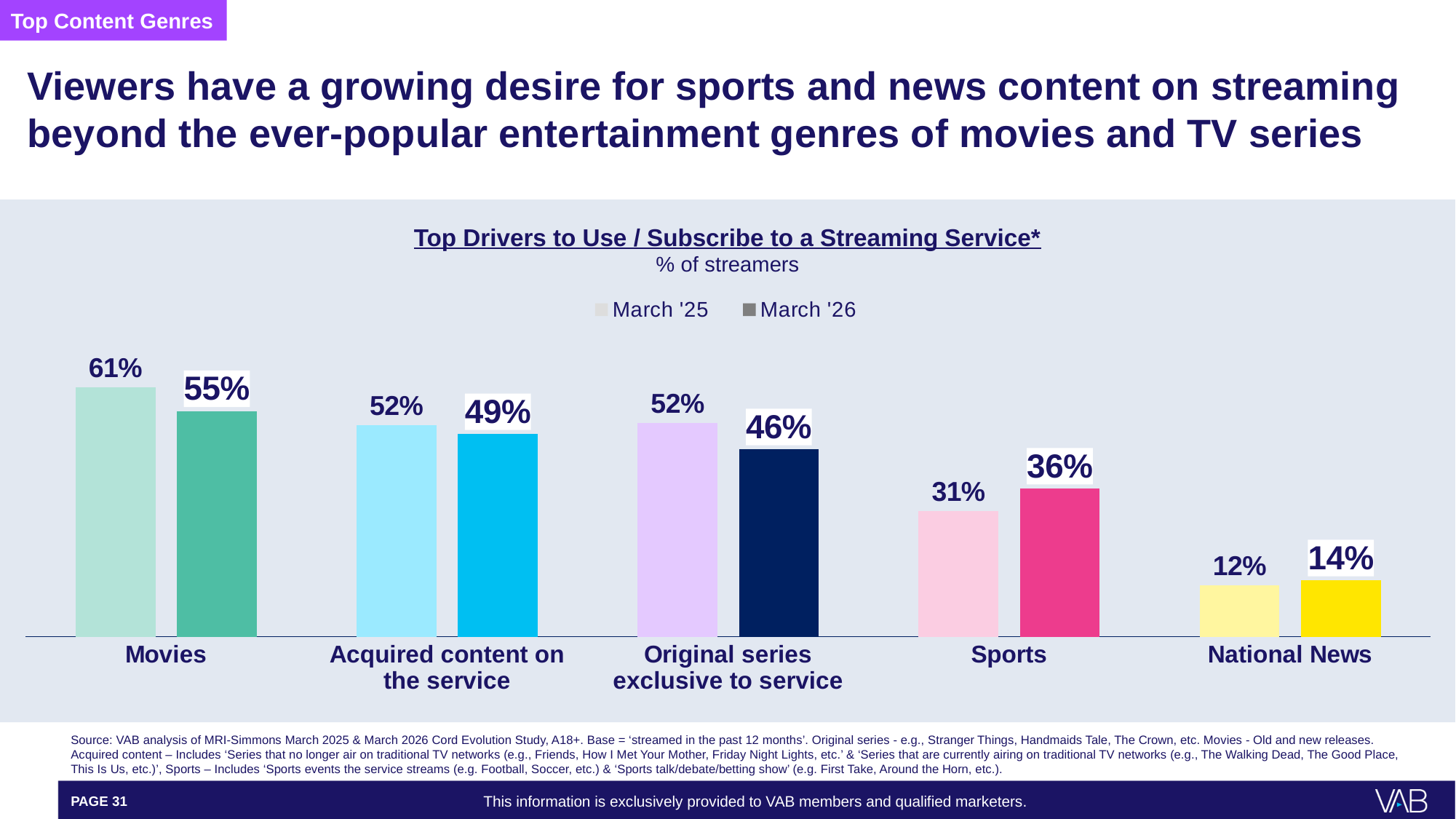
What is the title of the chart? Top Drivers to Use / Subscribe to a Streaming Service* What is the March '26 value for National News? 14% Which category has the highest March '26 value? Movies What is the March '26 value for Sports? 36% How many series does the legend list? 2 What is the March '25 value for Movies? 61% Which category has the lowest March '25 value? National News What is the difference between the March '25 and March '26 values for Sports? 5% What kind of chart is shown on the slide? Bar chart How many categories are shown on the x axis? 5 Which is larger for Original series exclusive to service: the March '25 value or the March '26 value? March '25 What is the difference between the March '25 and March '26 values for Movies? 6%